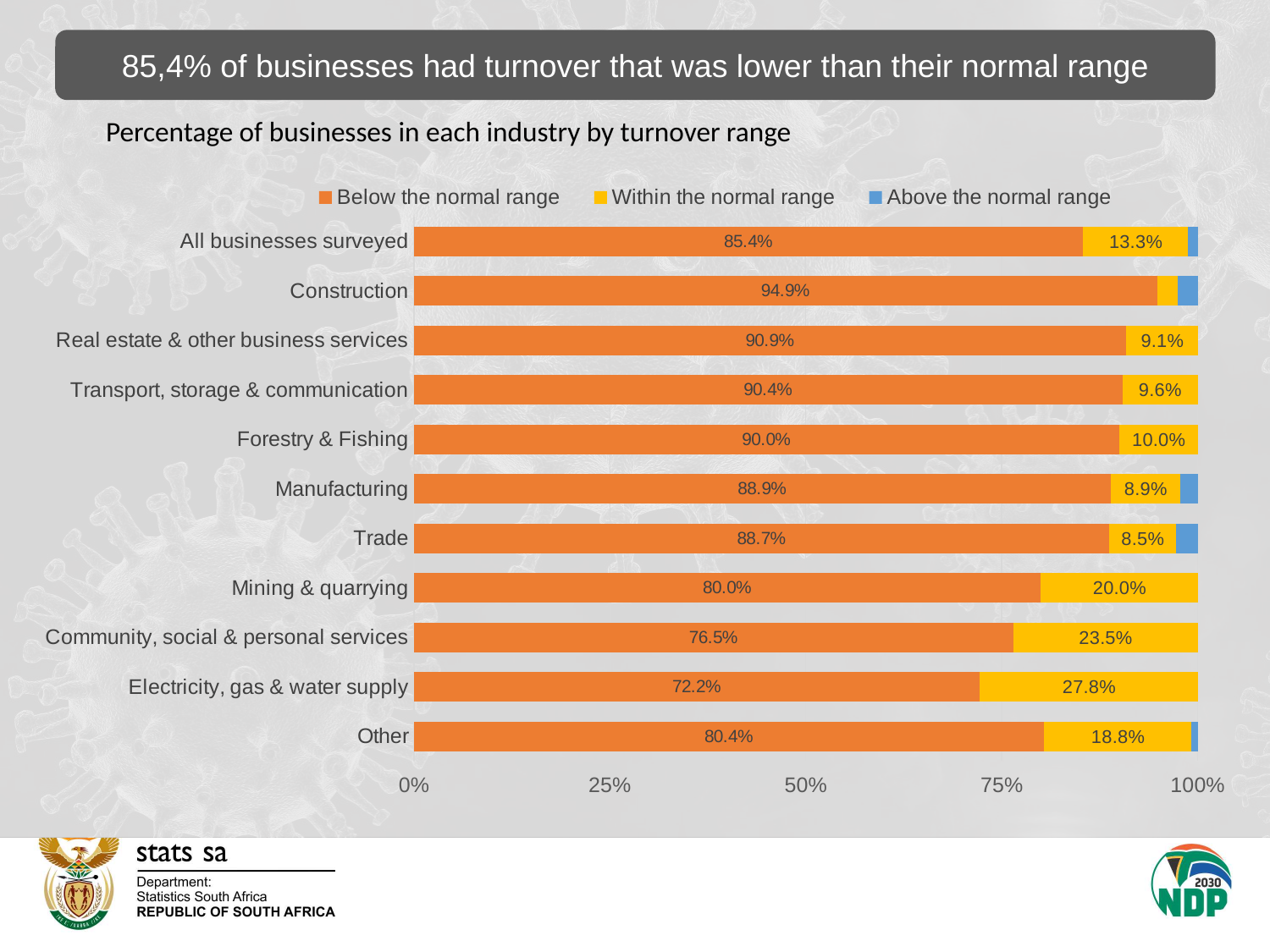
Is the 'Below the normal range' value for Trade greater or less than 75%? greater What percentage of Mining & quarrying businesses had turnover below the normal range? 80.0% Which industry has the lowest percentage of businesses with turnover below the normal range? Electricity, gas & water supply How many categories (rows) are shown in the chart? 11 What kind of chart is shown on the slide? Stacked bar chart Which has a larger 'Within the normal range' percentage, Mining & quarrying or Community, social & personal services? Community, social & personal services How many series does the legend list? 3 What is the difference between the 'Below the normal range' percentages for Construction and Electricity, gas & water supply? 22.7% Which industry has the highest percentage of businesses with turnover below the normal range? Construction What percentage of Electricity, gas & water supply businesses had turnover within the normal range? 27.8% What percentage of Construction businesses had turnover below the normal range? 94.9% Which colour represents 'Above the normal range' in the chart? Blue